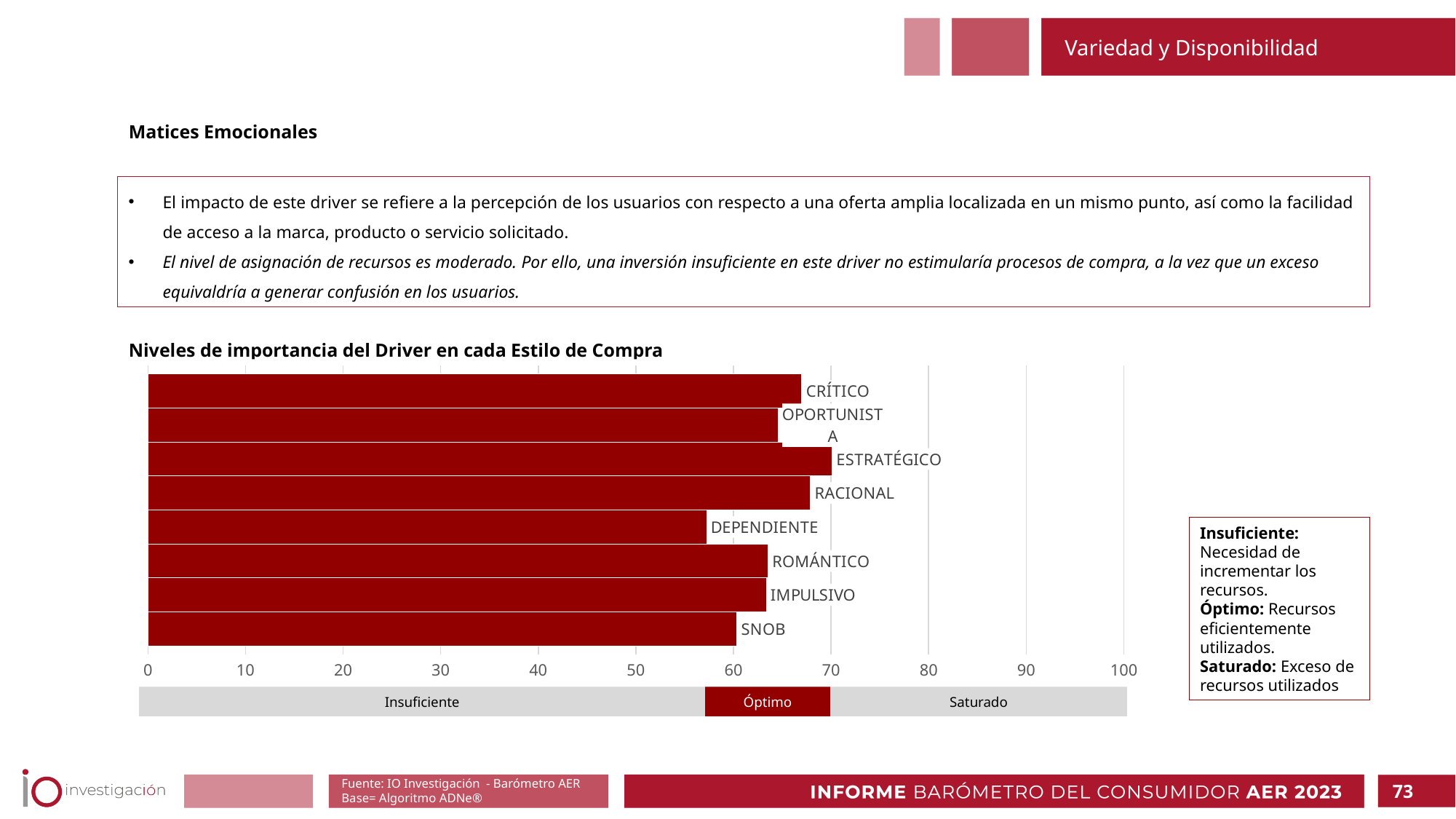
Is the value for SNOB greater or less than 50? greater What is the maximum value shown on the horizontal axis of the chart? 100 Which is larger, the value for CRÍTICO or the value for DEPENDIENTE? CRÍTICO Which purchase style has the highest value in the chart? ESTRATÉGICO Which is larger, the value for RACIONAL or the value for OPORTUNISTA? RACIONAL Is the value for DEPENDIENTE greater or less than 60? less Is the value for OPORTUNISTA greater or less than 70? less What are the three zone labels shown in the band below the chart's axis? Insuficiente, Óptimo, Saturado What kind of chart is shown under 'Niveles de importancia del Driver en cada Estilo de Compra'? bar chart Which purchase style has the lowest value in the chart? DEPENDIENTE How many purchase styles (categories) are plotted in the chart? 8